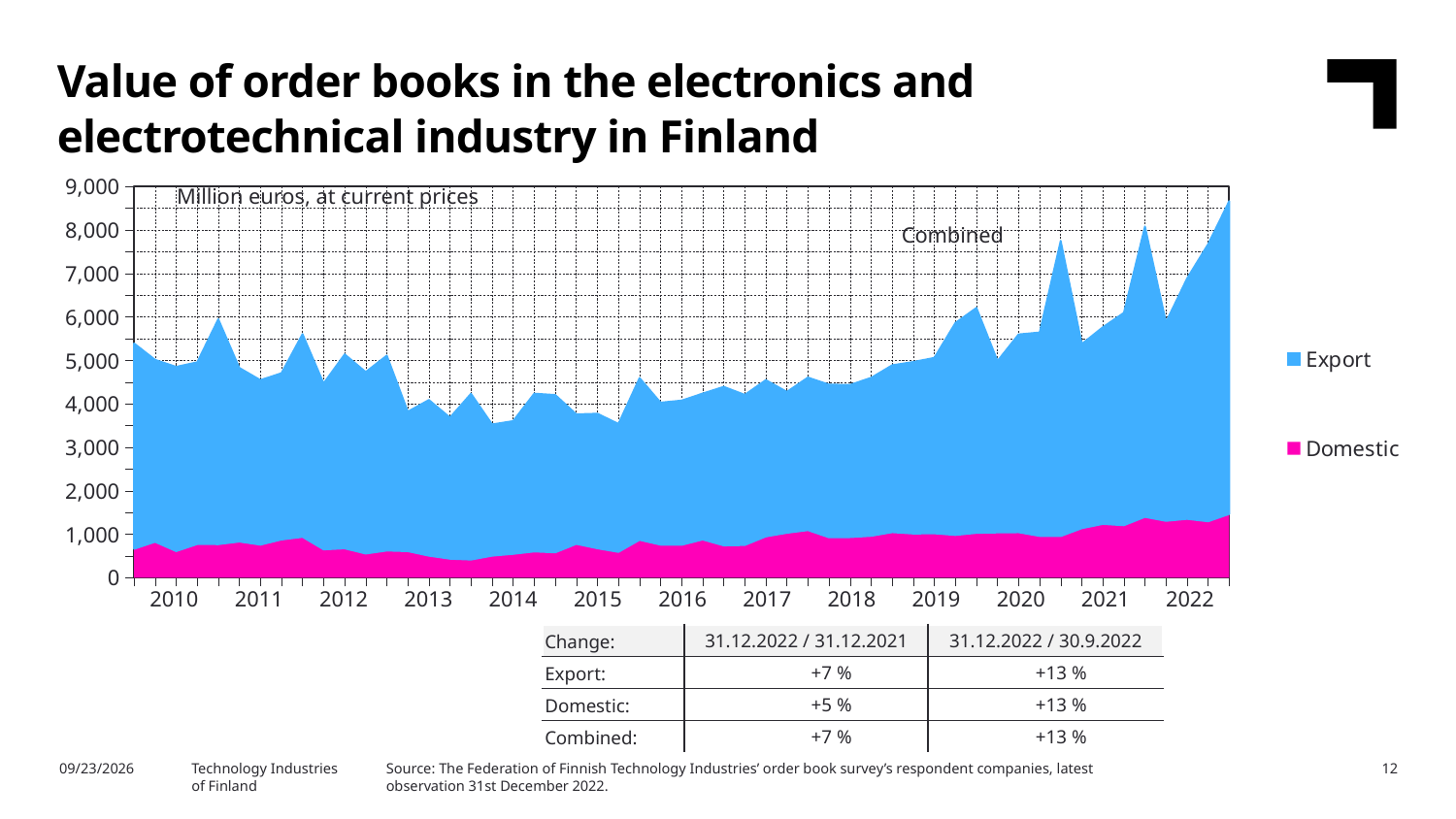
According to the table, what is the change in Domestic order books between 30.9.2022 and 31.12.2022? +13 % Is the combined value of order books in 2014 greater or less than 5,000? less How many years are labelled on the x axis of the chart? 13 What kind of chart is shown on the slide? Stacked area chart Which series, Export or Domestic, has the larger values throughout the chart? Export Is the combined value of order books at the end of 2022 greater or less than 8,000? greater Is the Domestic value at the end of 2022 greater or less than 1,000? greater Which two series are listed in the chart's legend? Export and Domestic How many series does the chart's legend list? 2 In what units are the values on the chart expressed? Million euros, at current prices According to the table, what is the change in Export order books between 31.12.2021 and 31.12.2022? +7 % Does the combined value of order books rise or fall from 2019 to the end of 2022? Rise